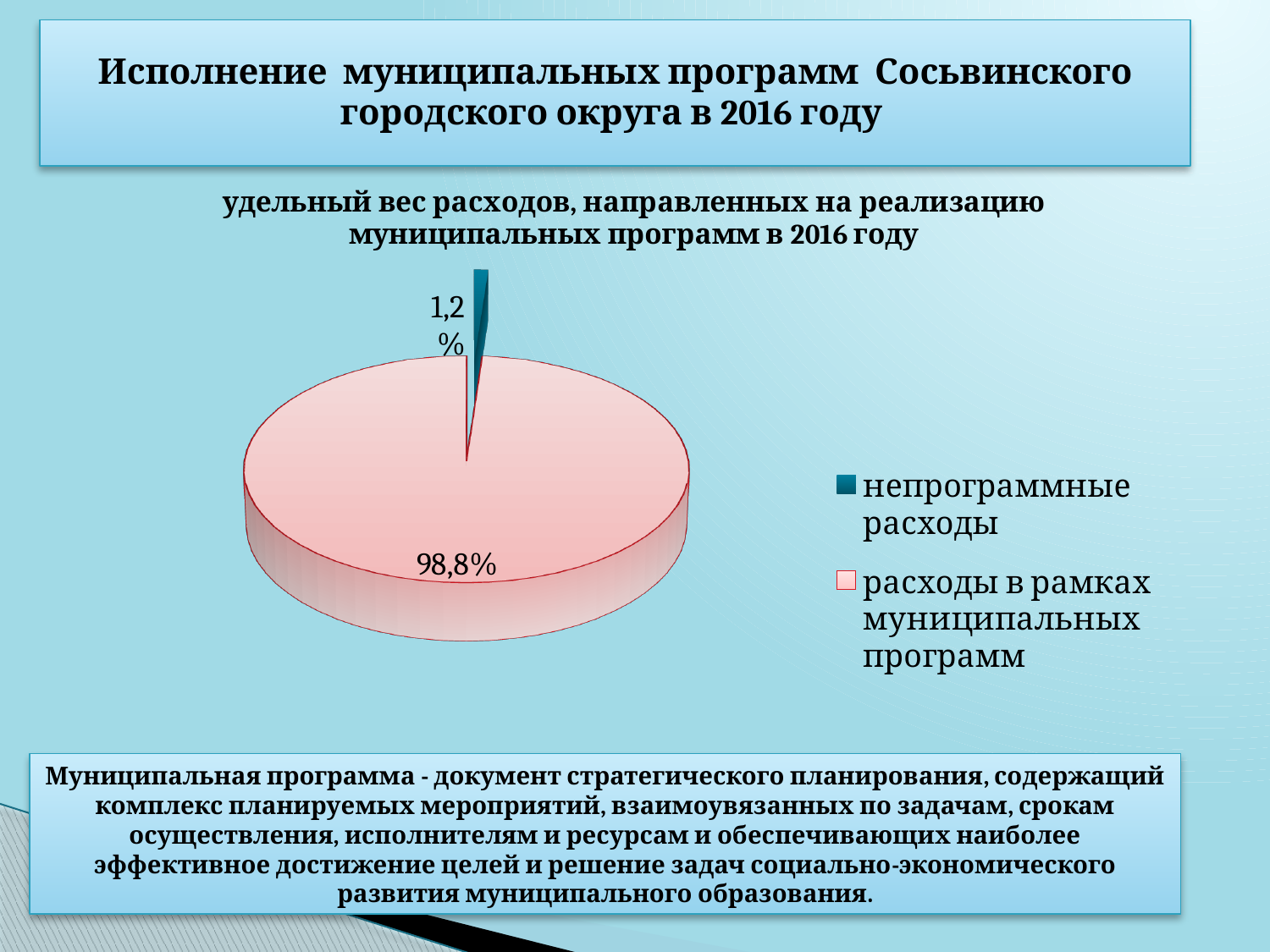
What share of the pie is labelled for 'непрограммные расходы'? 1,2% Which is larger: the slice for 'непрограммные расходы' or the slice for 'расходы в рамках муниципальных программ'? расходы в рамках муниципальных программ How many entries does the legend list? 2 Which category has the smallest slice of the pie? непрограммные расходы What is the difference in percentage points between 'расходы в рамках муниципальных программ' and 'непрограммные расходы'? 97,6 How many slices does the pie chart have? 2 Which category has the largest slice of the pie? расходы в рамках муниципальных программ What kind of chart is shown on the slide? Pie chart What is the title of the pie chart? удельный вес расходов, направленных на реализацию муниципальных программ в 2016 году What share of the pie is labelled for 'расходы в рамках муниципальных программ'? 98,8% What colour is the slice for 'непрограммные расходы'? Dark blue